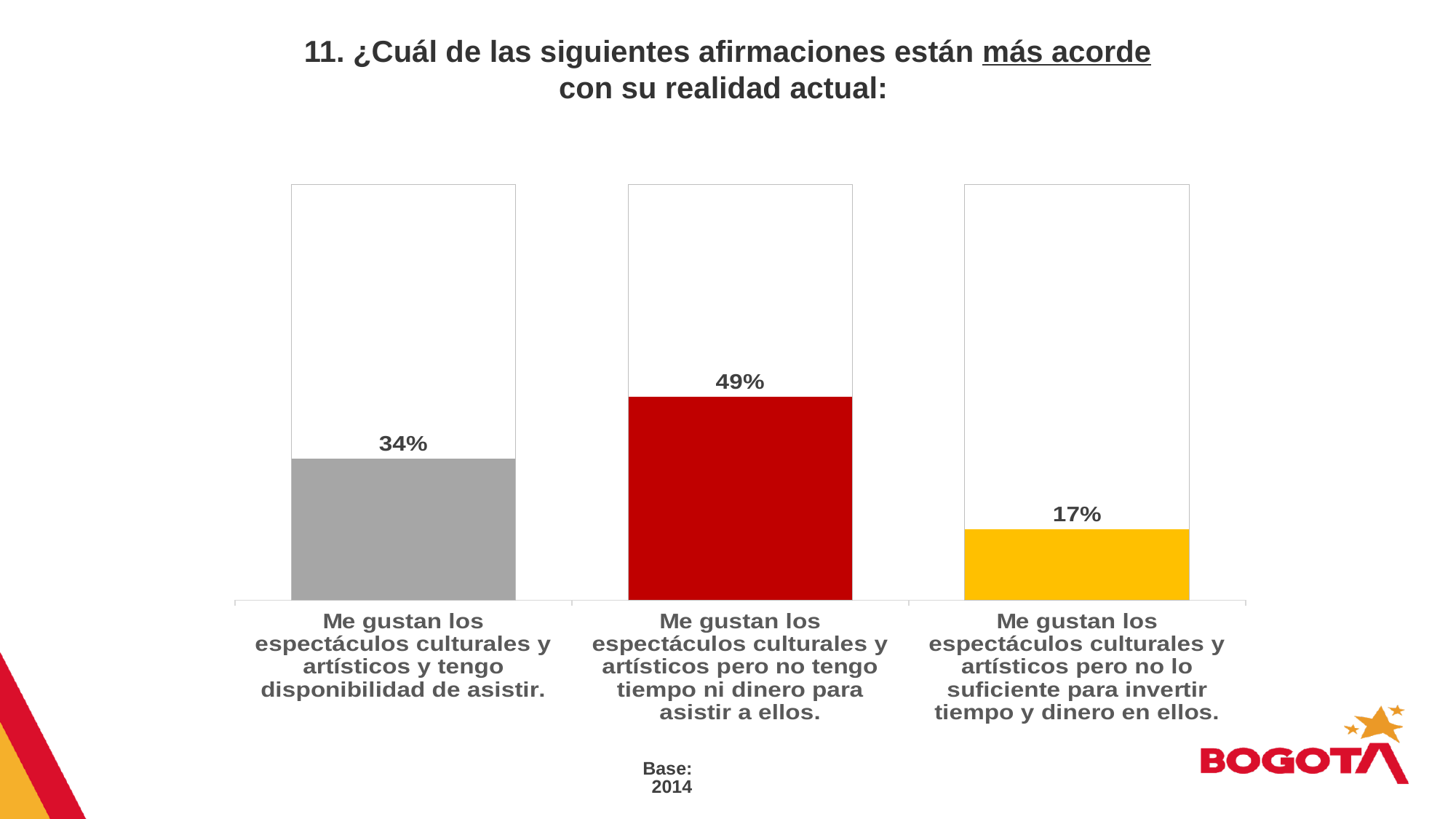
Which statement has the highest percentage? Me gustan los espectáculos culturales y artísticos pero no tengo tiempo ni dinero para asistir a ellos. What percentage of respondents said they like cultural and artistic shows and have the availability to attend ("Me gustan los espectáculos culturales y artísticos y tengo disponibilidad de asistir")? 34% What is the value for "Me gustan los espectáculos culturales y artísticos pero no lo suficiente para invertir tiempo y dinero en ellos"? 17% What kind of chart is shown on the slide? Bar chart What is the difference between the value for "no tengo tiempo ni dinero" (49%) and "tengo disponibilidad de asistir" (34%)? 15% What is the difference between the highest and lowest percentages shown? 32% What is the value for "Me gustan los espectáculos culturales y artísticos pero no tengo tiempo ni dinero para asistir a ellos"? 49% Which is larger: the value for "tengo disponibilidad de asistir" or the value for "no lo suficiente para invertir tiempo y dinero"? Me gustan los espectáculos culturales y artísticos y tengo disponibilidad de asistir. What base year is indicated below the chart? 2014 How many statements (categories) are shown in the chart? 3 Which statement has the lowest percentage? Me gustan los espectáculos culturales y artísticos pero no lo suficiente para invertir tiempo y dinero en ellos. What colour is the bar for the statement with 49%? Red